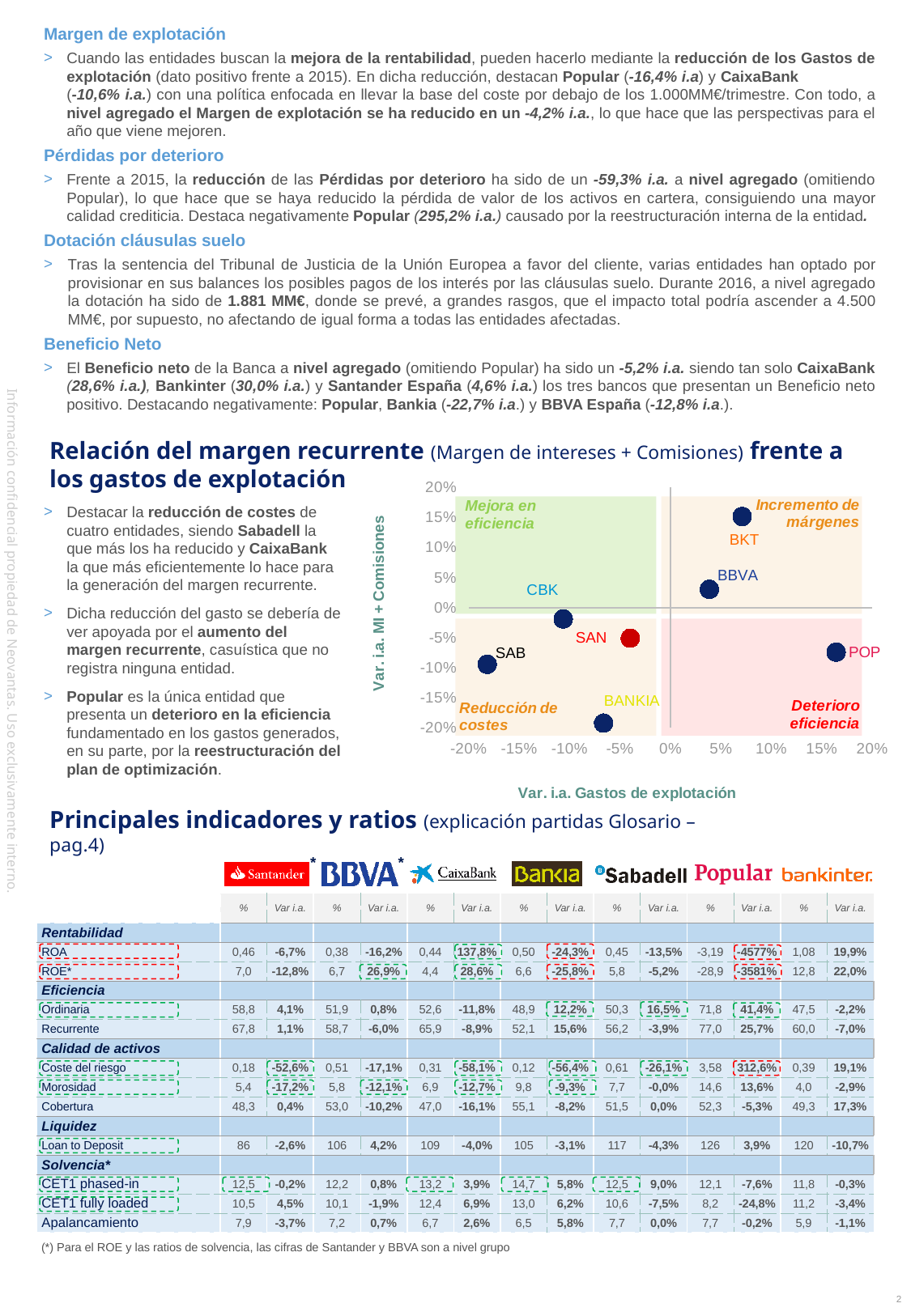
In the scatter chart, is the vertical-axis value (Var. i.a. MI + Comisiones) for BKT greater or less than 10%? greater In the scatter chart, is the vertical-axis value (Var. i.a. MI + Comisiones) for BANKIA greater or less than -15%? less What text labels the top-left quadrant of the scatter chart? Mejora en eficiencia In the scatter chart, which entity has a higher vertical-axis value (Var. i.a. MI + Comisiones), BKT or BBVA? BKT In the scatter chart, which entity has the lowest value on the horizontal axis (Var. i.a. Gastos de explotación)? SAB How many entities are plotted as points in the scatter chart? 7 What kind of chart is the 'Relación del margen recurrente frente a los gastos de explotación' chart? scatter chart In the scatter chart, is the horizontal-axis value (Var. i.a. Gastos de explotación) for SAB greater or less than -15%? less In the scatter chart, which entity has the lowest value on the vertical axis (Var. i.a. MI + Comisiones)? BANKIA What is the label of the horizontal axis of the scatter chart? Var. i.a. Gastos de explotación In the scatter chart, which entity has the highest value on the horizontal axis (Var. i.a. Gastos de explotación)? POP In the scatter chart, which entity has the highest value on the vertical axis (Var. i.a. MI + Comisiones)? BKT